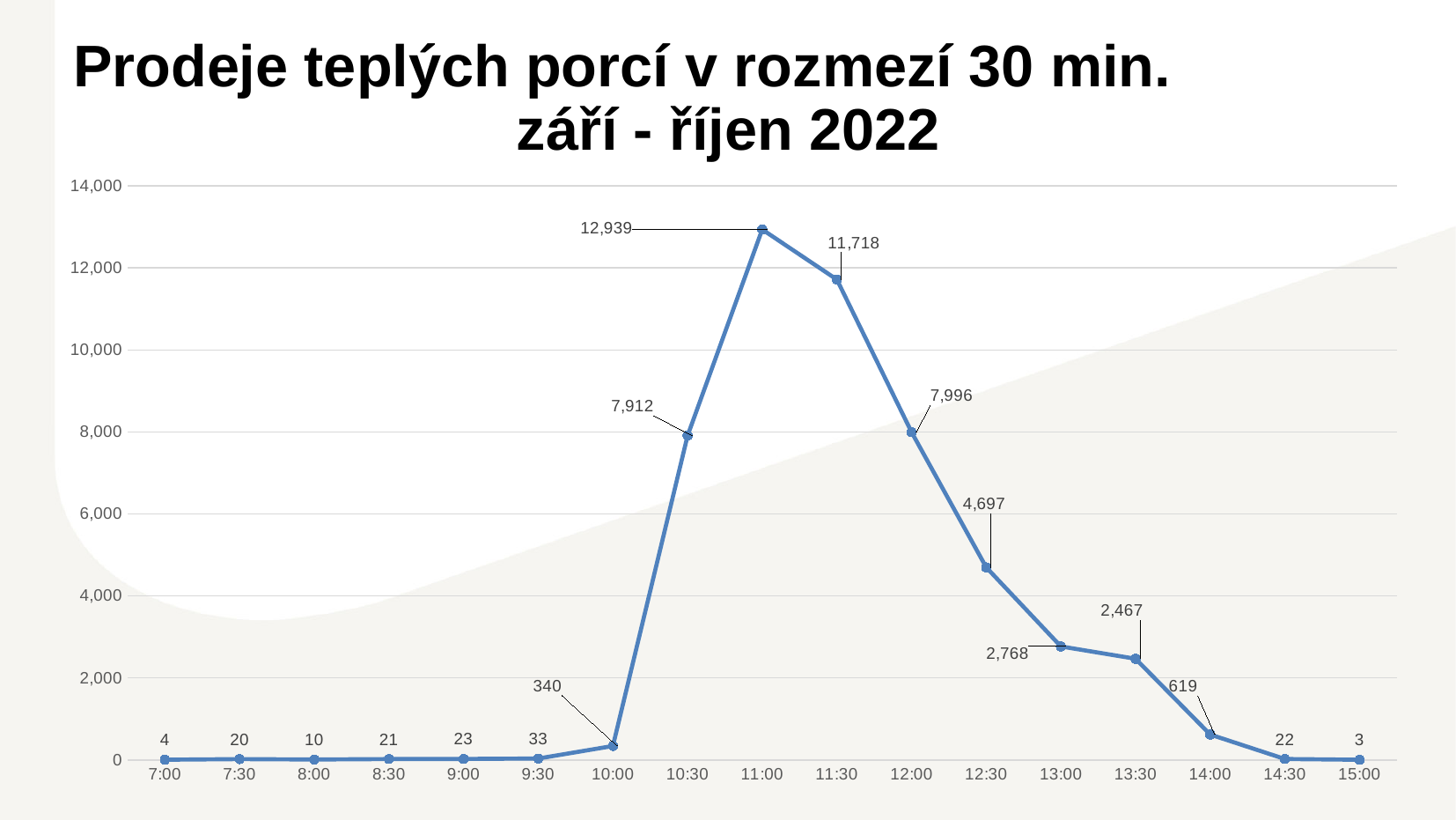
How many time points are plotted on the x axis? 17 At which time is the value lowest? 15:00 What is the value at 13:30? 2,467 Is the value at 12:30 greater or less than 4,000? greater What is the value at 11:00? 12,939 Which is larger, the value at 10:30 or the value at 12:00? 12:00 What type of chart is shown on the slide? line chart What is the difference between the values at 11:00 and 11:30? 1,221 What is the difference between the values at 12:30 and 13:00? 1,929 What is the value at 10:00? 340 At which time is the value highest? 11:00 Do the values rise or fall between 11:00 and 15:00? fall